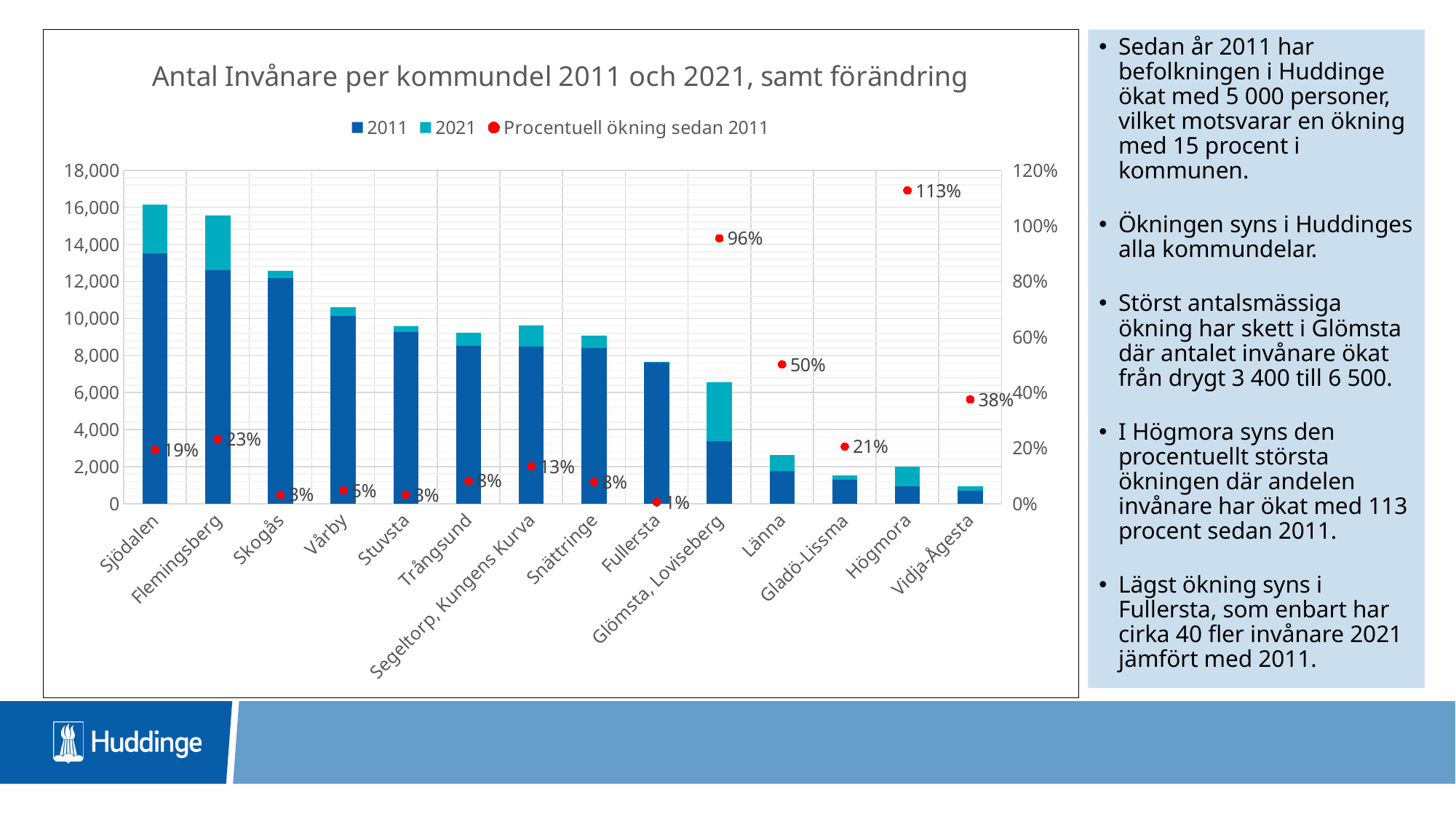
What is the title of the chart? Antal Invånare per kommundel 2011 och 2021, samt förändring How many series does the legend list? 3 Which kommundel has the highest percentage increase since 2011? Högmora How many kommundelar are shown on the x axis? 14 What is the percentage increase since 2011 shown for Glömsta, Loviseberg? 96% Which has a larger percentage increase since 2011, Länna or Vidja-Ågesta? Länna What is the percentage increase since 2011 shown for Högmora? 113% How many percentage points higher is the increase for Högmora than for Glömsta, Loviseberg? 17 percentage points Is the total stacked bar value for Vidja-Ågesta greater or less than 2,000? less Which kommundel has the lowest percentage increase since 2011? Fullersta What is the percentage increase since 2011 shown for Sjödalen? 19% Is the total stacked bar value for Flemingsberg greater or less than 14,000? greater